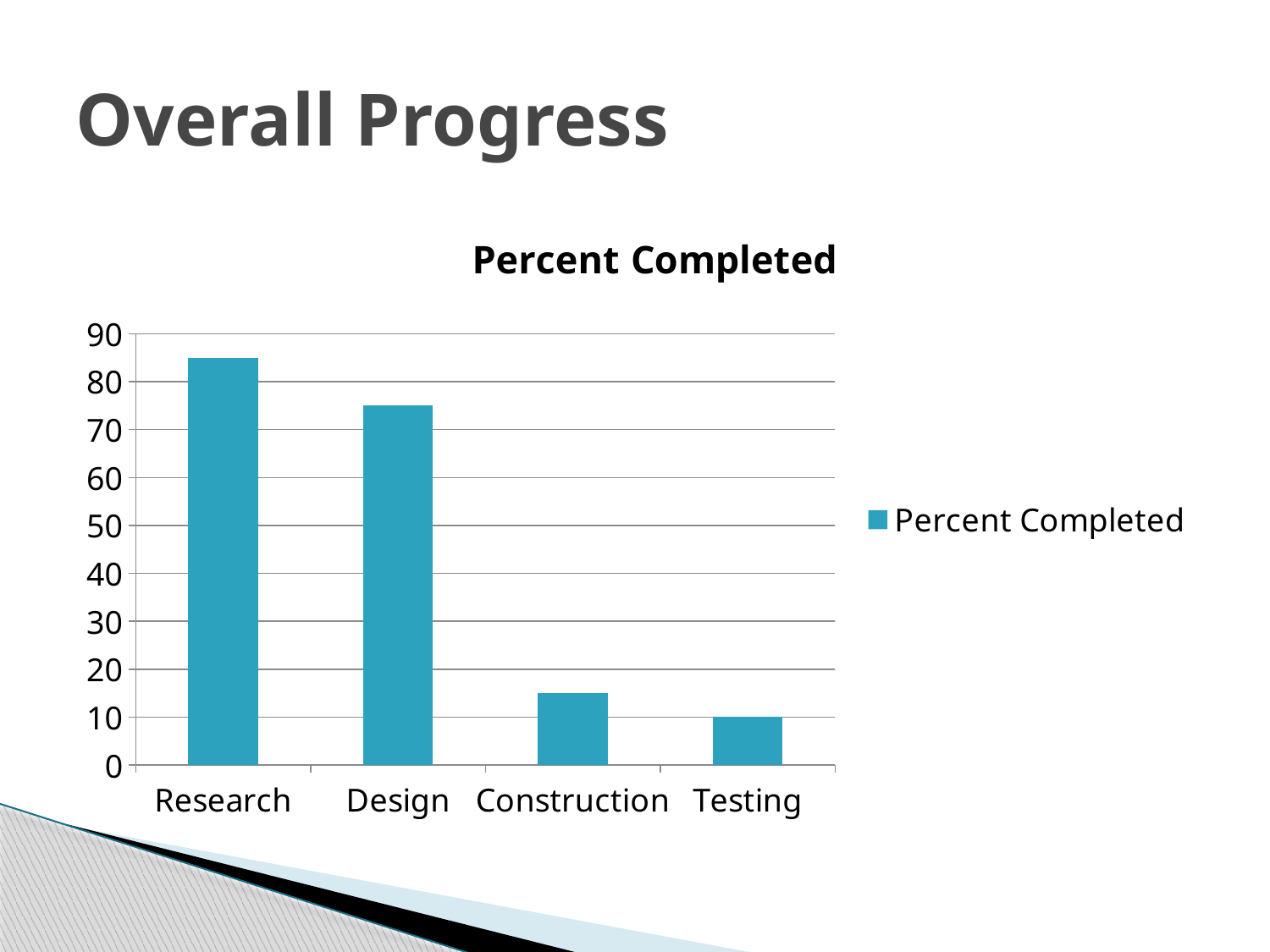
How many series does the legend list? 1 Which category has the highest percent completed? Research Is the value for Construction greater or less than 20? less Is the value for Design greater or less than 80? less What is the title of the chart? Percent Completed Is the value for Research greater or less than 80? greater Which is larger, the value for Construction or the value for Testing? Construction How many categories are shown on the x axis of the chart? 4 What kind of chart is shown on the slide? bar chart Do the values rise or fall from Research to Testing along the x axis? fall Which is larger, the value for Research or the value for Design? Research Which category has the lowest percent completed? Testing